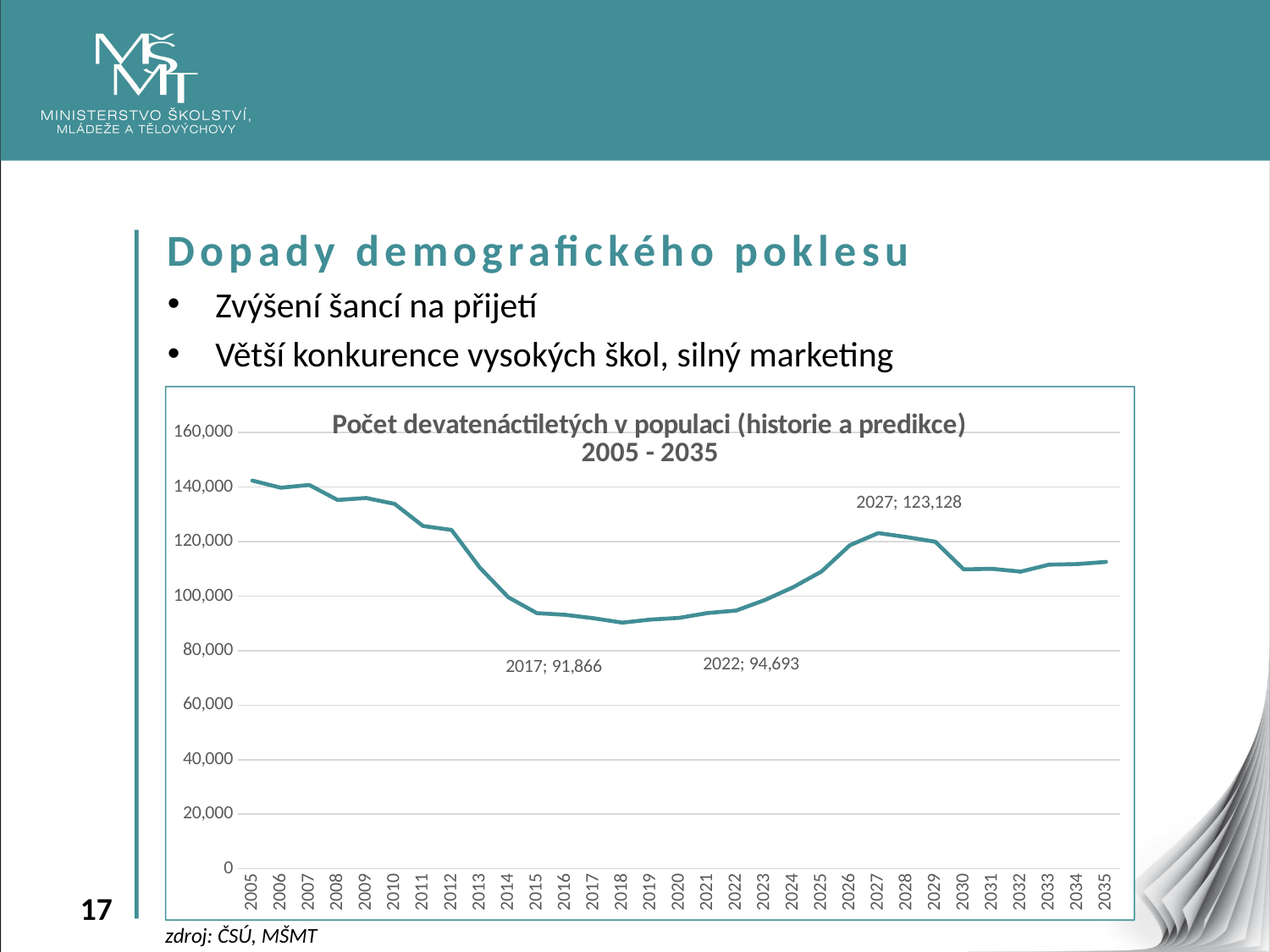
Which year has the highest value on the chart? 2005 Is the value for 2030 greater or less than 120,000? less Is the value for 2018 greater or less than 100,000? less What is the difference between the values for 2027 and 2017? 31,262 What is the difference between the values for 2022 and 2017? 2,827 Which is larger, the value for 2022 or the value for 2017? 2022 How many years are plotted on the x axis? 31 What is the value for 2022? 94,693 What is the value for 2017? 91,866 What is the value for 2027? 123,128 Is the value for 2010 greater or less than 120,000? greater What kind of chart is shown on the slide? line chart